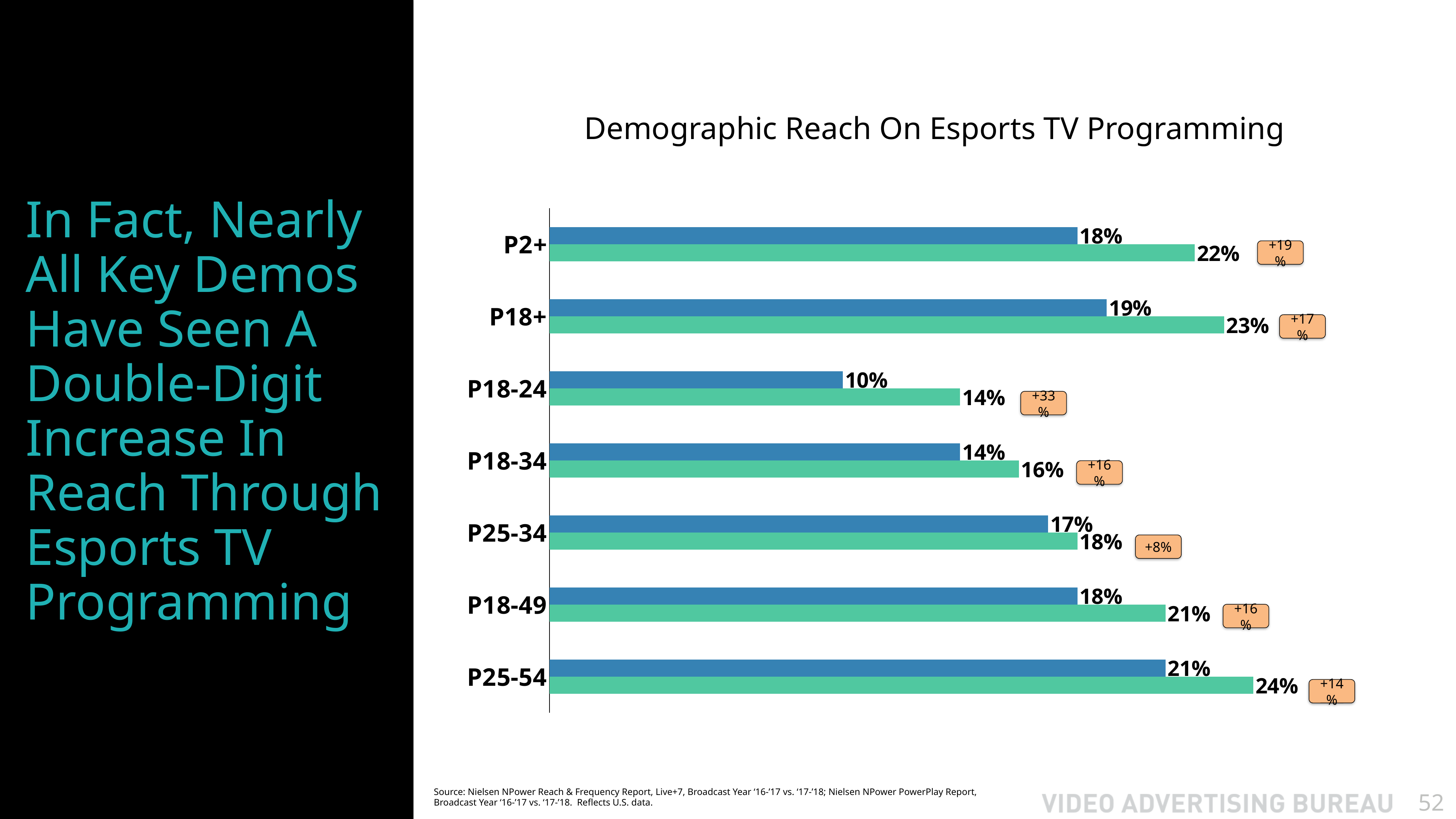
What kind of chart is shown on the slide? Bar chart What is the title of the chart? Demographic Reach On Esports TV Programming Which demographic shows the largest percentage increase label? P18-24 What is the difference between the green bar and the blue bar for P18+? 4 percentage points What is the value of the blue bar for P18-24? 10% What percentage increase is shown for P25-34? +8% Which is larger: the green bar for P2+ or the green bar for P18-49? P2+ How many demographic categories are shown in the chart? 7 Which demographic has the lowest blue bar value? P18-24 Which demographic has the highest green bar value? P25-54 What is the value of the green bar for P18+? 23% What is the value of the green bar for P25-54? 24%